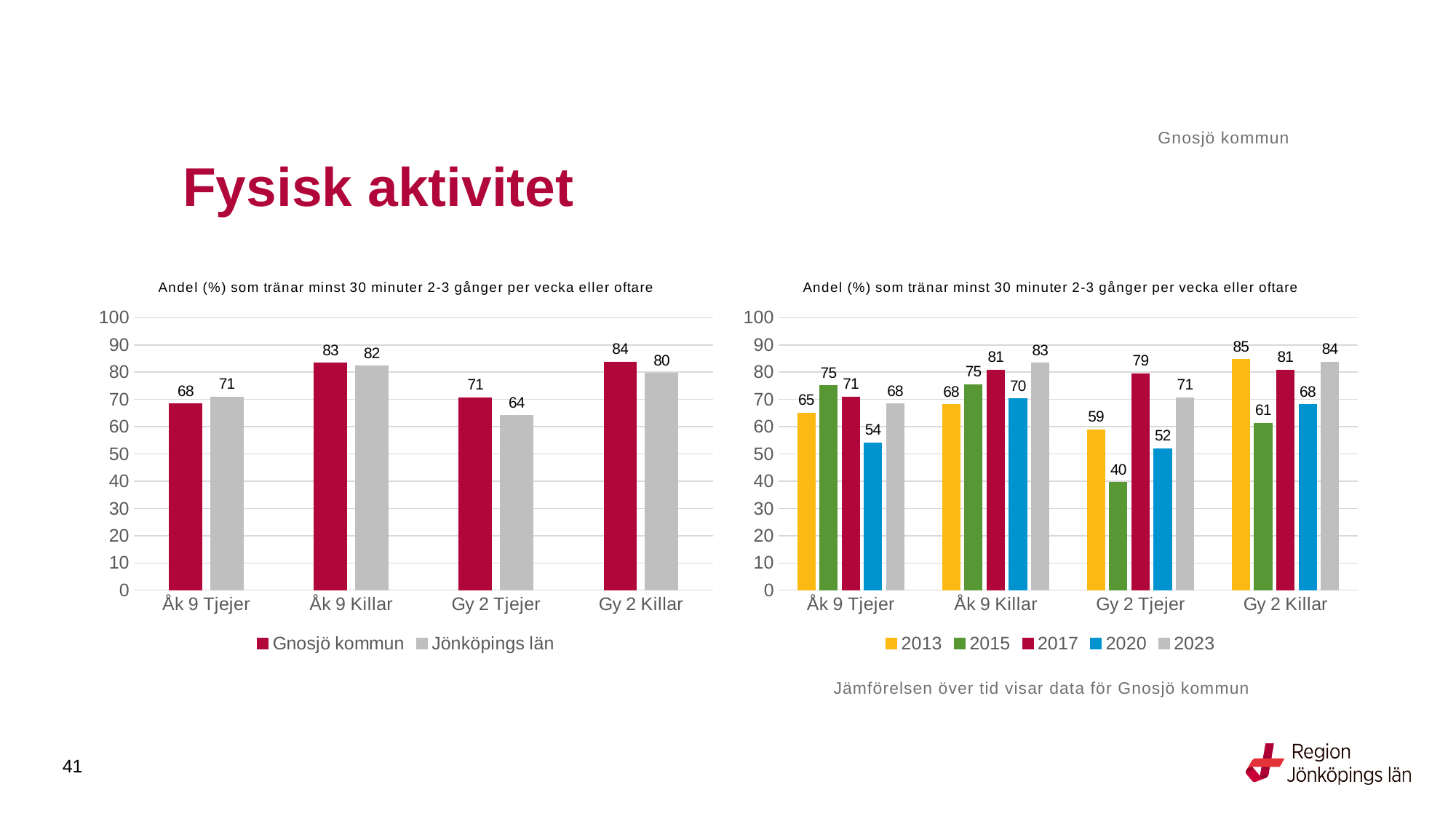
What kind of chart is the right chart? Bar chart In the right chart, what is the value for 2020 for Åk 9 Tjejer? 54 In the left chart, what is the value for Jönköpings län for Åk 9 Killar? 82 In the right chart, which category has the highest value for 2013? Gy 2 Killar In the left chart, what is the difference between Gnosjö kommun and Jönköpings län for Gy 2 Tjejer? 7 In the right chart, how many series does the legend list? 5 In the left chart, what is the value for Gnosjö kommun for Gy 2 Tjejer? 71 In the left chart, which category has the lowest value for Jönköpings län? Gy 2 Tjejer In the right chart, which is larger for Gy 2 Killar: the value for 2013 or the value for 2015? 2013 In the right chart, what is the value for 2015 for Gy 2 Tjejer? 40 In the right chart, what is the difference between the 2017 and 2020 values for Gy 2 Tjejer? 27 In the left chart, how many series does the legend list? 2